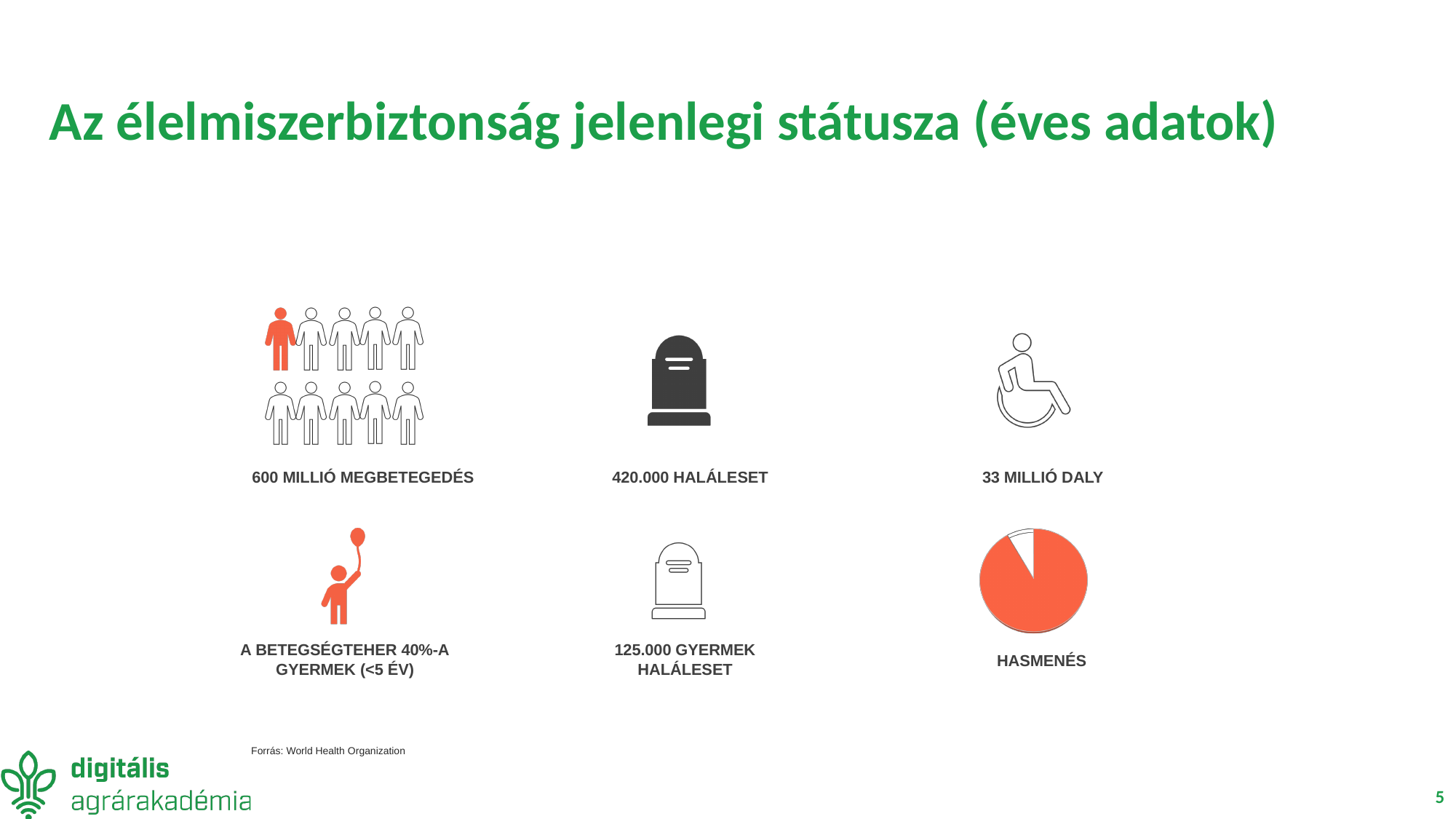
How many slices does the HASMENÉS pie chart have? 2 In the HASMENÉS pie chart, which slice is larger, the orange one or the white one? the orange one What colour is the largest slice of the HASMENÉS pie chart? orange What label is printed under the pie chart on the slide? HASMENÉS What kind of chart is shown next to the label HASMENÉS? pie chart Does the HASMENÉS pie chart show any data labels or a legend? no In the HASMENÉS pie chart, is the orange slice greater or less than half of the pie? greater